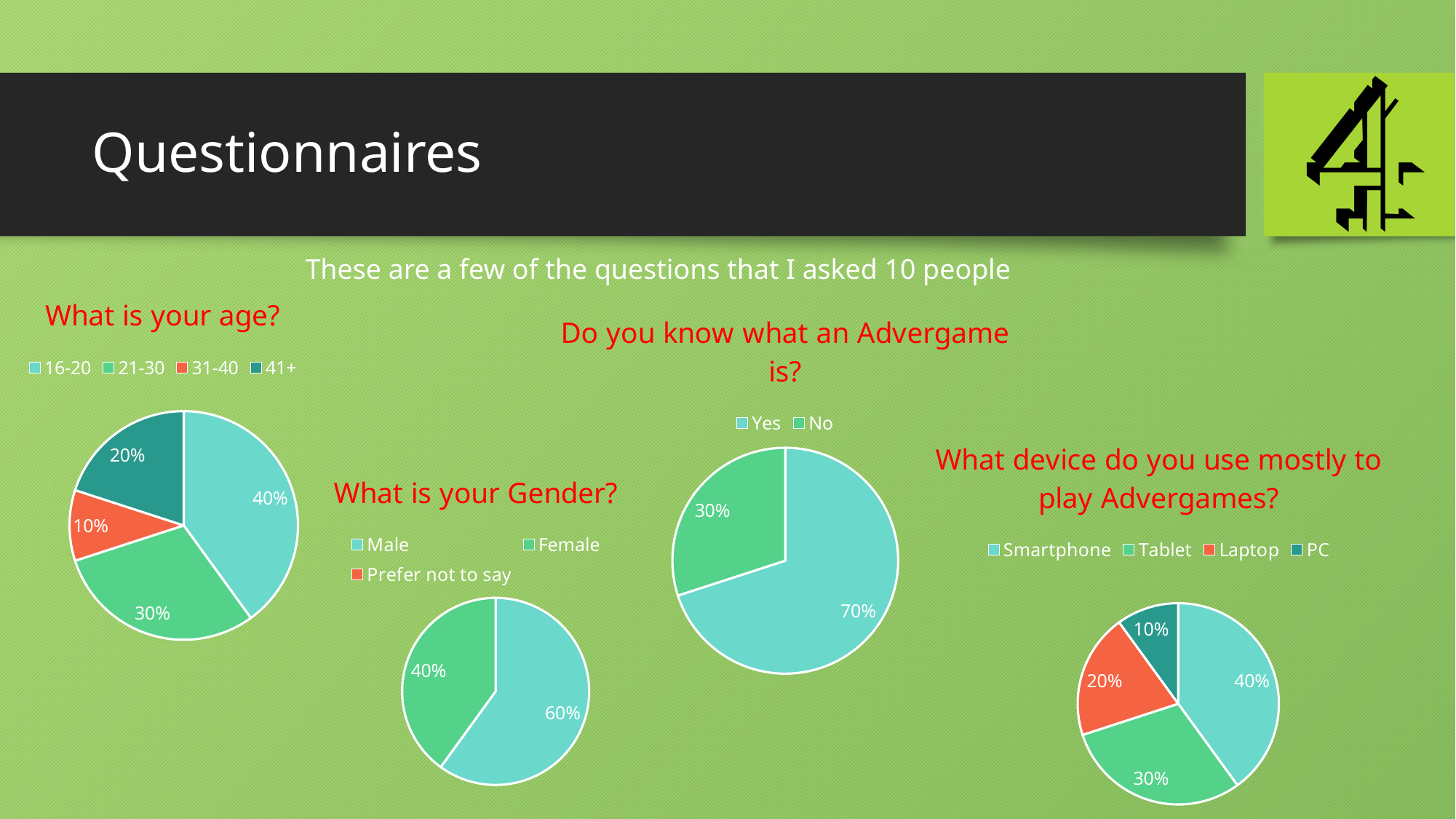
In the 'What device do you use mostly to play Advergames?' chart, which device has the largest share? Smartphone In the 'What is your Gender?' chart, how many entries does the legend list? 3 In the 'Do you know what an Advergame is?' chart, what share answered Yes? 70% In the 'What is your age?' chart, which age group has the smallest share? 31-40 In the 'What is your age?' chart, what share of respondents are aged 16-20? 40% In the 'What device do you use mostly to play Advergames?' chart, what share of respondents use a Laptop? 20% In the 'What device do you use mostly to play Advergames?' chart, how many device categories are shown in the legend? 4 In the 'What is your age?' chart, what is the difference between the 21-30 share and the 41+ share? 10% In the 'What is your Gender?' chart, what share of respondents are Male? 60% How many charts are shown on the slide? 4 What type of chart is used for 'What is your age?'? Pie chart In the 'Do you know what an Advergame is?' chart, which answer has the larger share, Yes or No? Yes